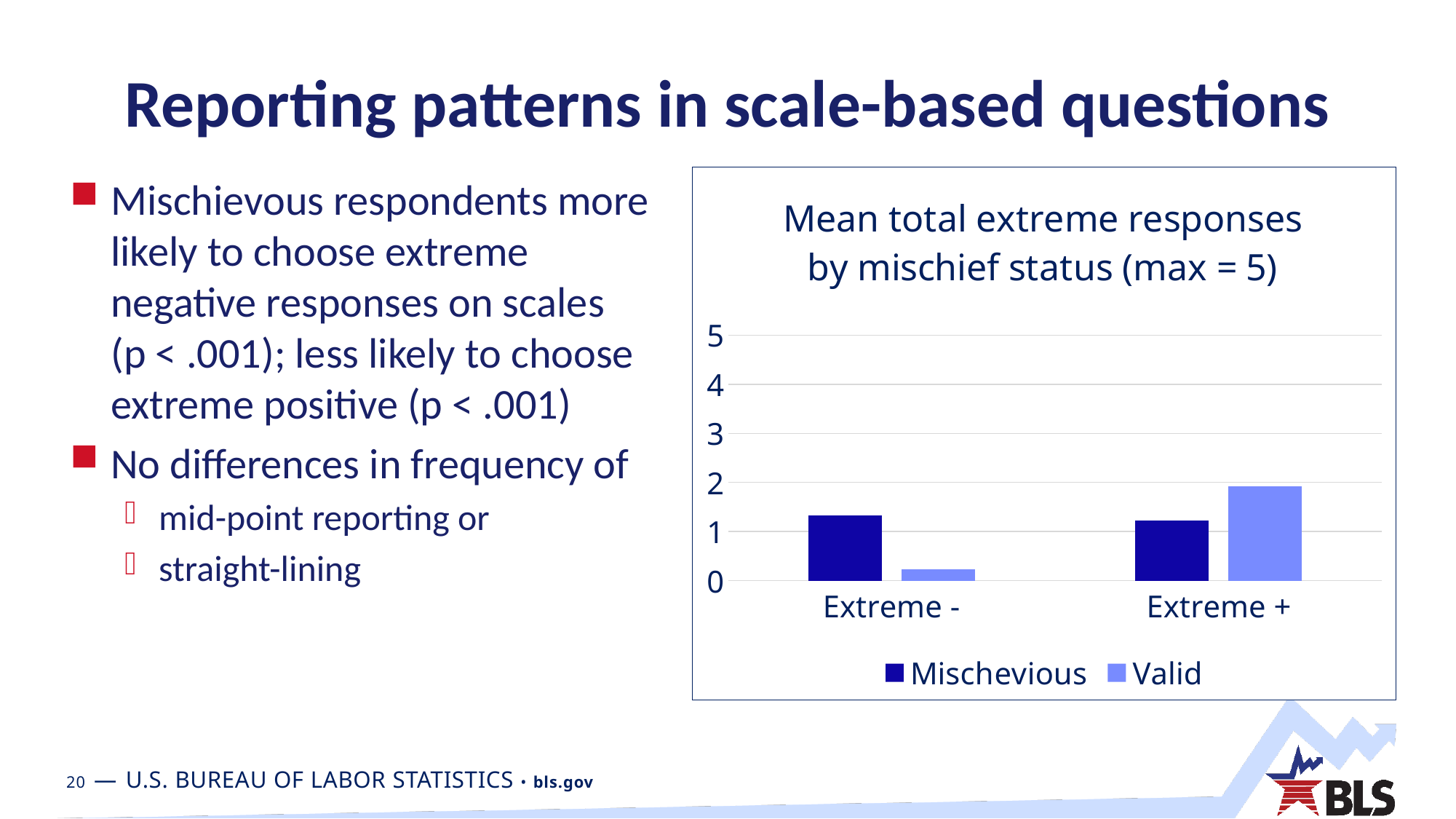
How many series does the chart's legend list? 2 Is the Valid value for Extreme - greater or less than 1? less For the Extreme + category, which series has the larger value, Mischevious or Valid? Valid Which bar in the chart is the tallest? Valid, Extreme + How many categories are shown on the x axis of the chart? 2 Is the Mischevious value for Extreme - greater or less than 1? greater Which series is shown in dark blue in the chart? Mischevious What is the title of the chart? Mean total extreme responses by mischief status (max = 5) For the Extreme - category, which series has the larger value, Mischevious or Valid? Mischevious Which bar in the chart is the shortest? Valid, Extreme - Is the Valid value for Extreme + greater or less than 1? greater What kind of chart is shown on the slide? bar chart